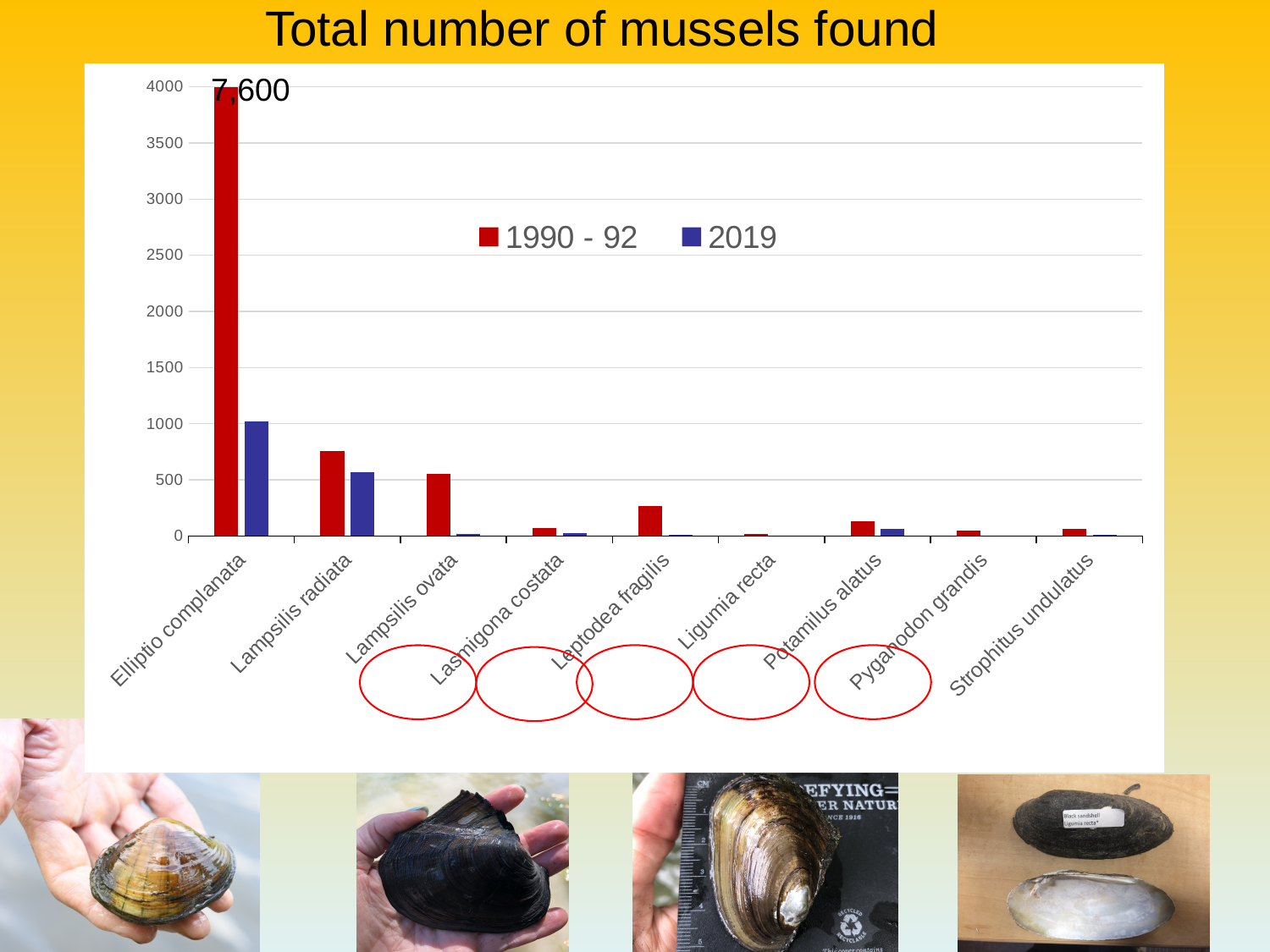
What is the title of the chart? Total number of mussels found What value is printed for Elliptio complanata in the 1990 - 92 series? 7,600 For Elliptio complanata, which series has the larger value, 1990 - 92 or 2019? 1990 - 92 Which species has the highest value in the 2019 series? Elliptio complanata For Lampsilis radiata, which series has the larger value, 1990 - 92 or 2019? 1990 - 92 How many series does the legend list? 2 Which species has the highest value in the 1990 - 92 series? Elliptio complanata What kind of chart is shown on the slide? bar chart Is the 1990 - 92 value for Leptodea fragilis greater or less than 500? less Which colour represents the 2019 series in the legend? blue How many mussel species (categories) are shown on the x axis? 9 Is the 1990 - 92 value for Lampsilis radiata greater or less than 500? greater